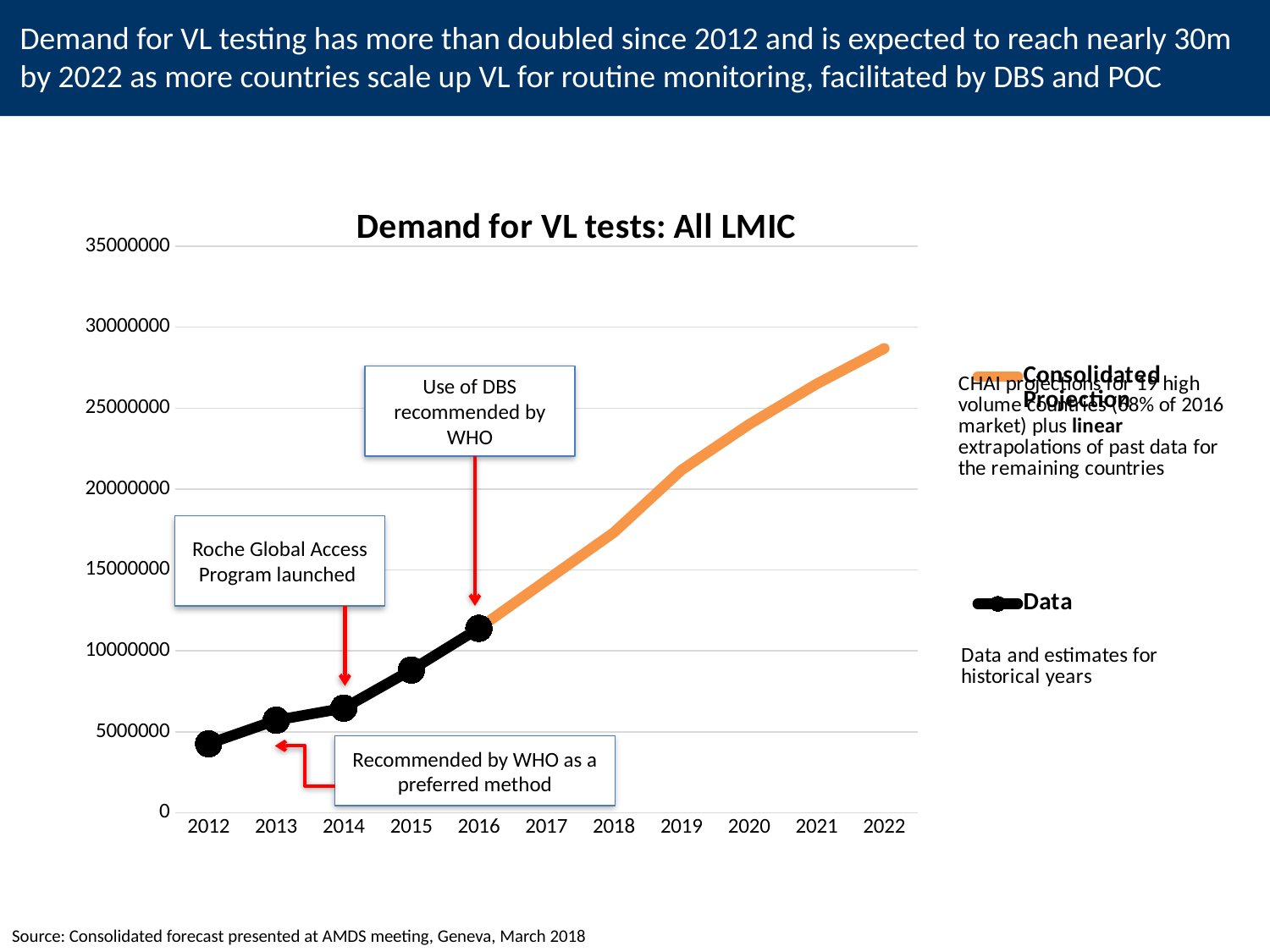
Is the value for 2012 greater or less than 5000000? less Do the values on the chart rise or fall from 2012 to 2022? Rise What kind of chart is shown on the slide? Line chart Which year has the lowest demand for VL tests on the chart? 2012 Is the value for 2016 greater or less than 10000000? greater Is the value for 2022 greater or less than 30000000? less Which series is drawn in orange on the chart? Consolidated Projection How many series does the chart's legend list? 2 How many years are shown along the x axis of the chart? 11 What is the title of the chart? Demand for VL tests: All LMIC Which year has the highest demand for VL tests on the chart? 2022